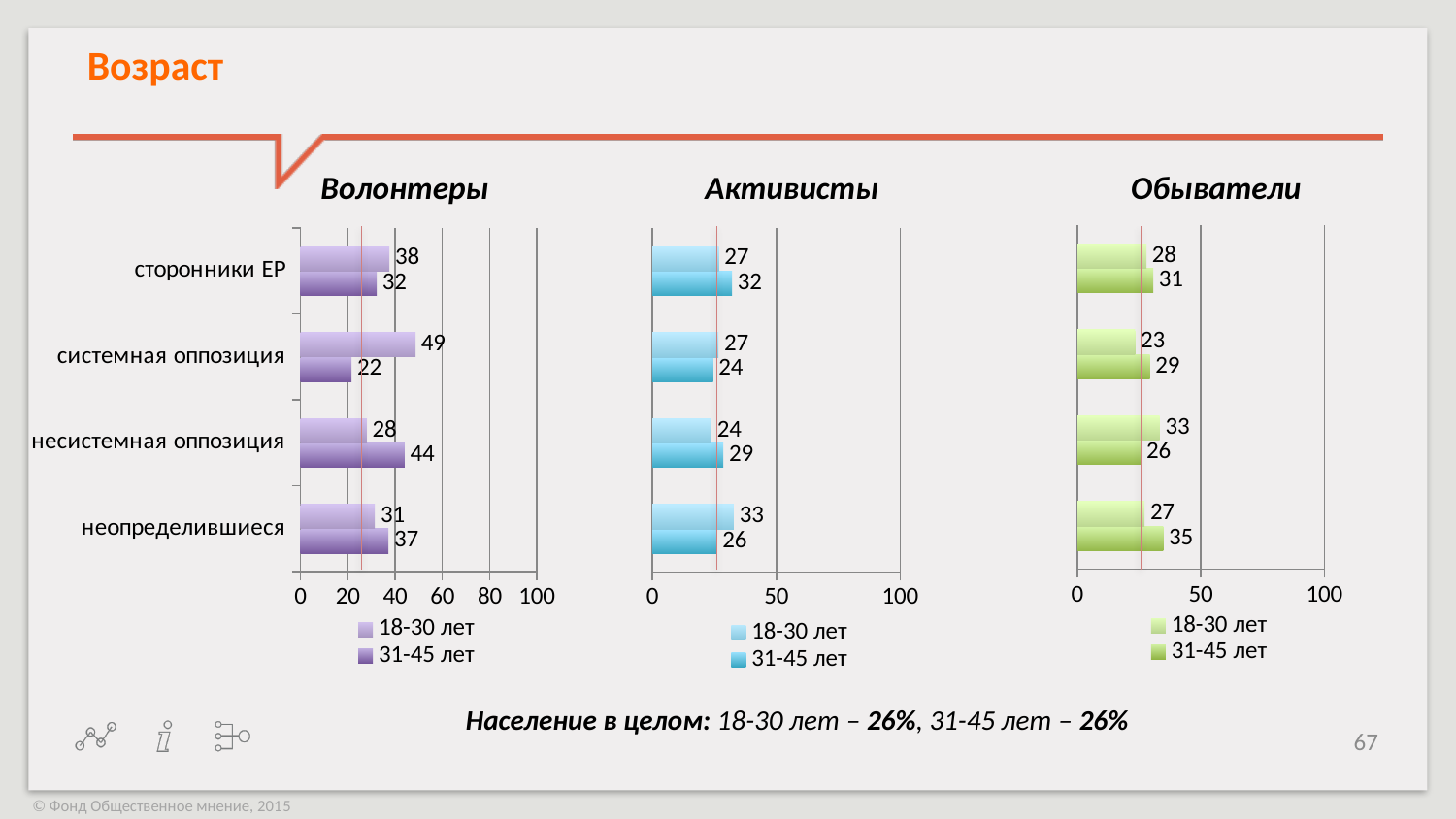
In the Обыватели chart, is the 31-45 лет value for неопределившиеся greater or less than 50? less In the Обыватели chart, which category has the lowest value in the 18-30 лет series? системная оппозиция In the Активисты chart, what is the difference between the 18-30 лет and 31-45 лет values for несистемная оппозиция? 5 How many categories are shown in the Активисты chart? 4 In the Волонтеры chart, what is the difference between the 18-30 лет and 31-45 лет values for системная оппозиция? 27 In the Активисты chart, what is the value for неопределившиеся in the 31-45 лет series? 26 In the Активисты chart, which is larger for сторонники ЕР: the 18-30 лет value or the 31-45 лет value? 31-45 лет In the Волонтеры chart, which category has the highest value in the 31-45 лет series? несистемная оппозиция How many series does the legend of the Волонтеры chart list? 2 What type of chart is the Обыватели chart? bar chart In the Волонтеры chart, what is the value for системная оппозиция in the 18-30 лет series? 49 In the Обыватели chart, what is the value for сторонники ЕР in the 31-45 лет series? 31